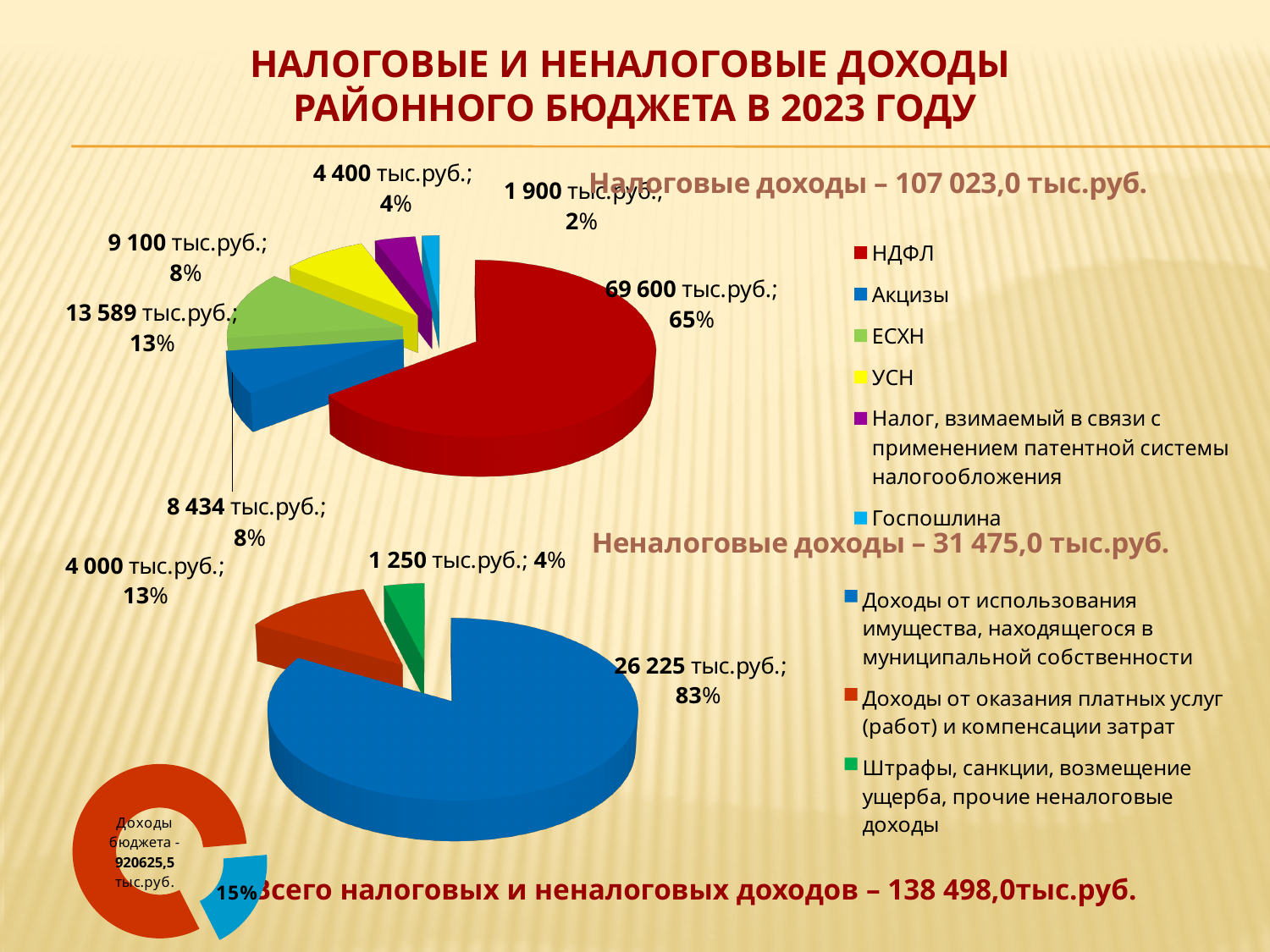
In the top chart (Налоговые доходы), which category has the largest slice? НДФЛ What kind of chart is the top chart (Налоговые доходы)? pie chart In the bottom chart (Неналоговые доходы), what is the value for Доходы от использования имущества, находящегося в муниципальной собственности? 26 225 тыс.руб. According to the heading of the top chart, what is the total of Налоговые доходы? 107 023,0 тыс.руб. In the bottom chart (Неналоговые доходы), what is the difference between the value for Доходы от использования имущества (26 225 тыс.руб.) and Доходы от оказания платных услуг (4 000 тыс.руб.)? 22 225 тыс.руб. In the top chart (Налоговые доходы), what share of the pie does Госпошлина take? 2% In the top chart (Налоговые доходы), which category has the smallest slice? Госпошлина In the bottom chart (Неналоговые доходы), what share of the pie do Штрафы, санкции, возмещение ущерба, прочие неналоговые доходы take? 4% In the top chart (Налоговые доходы), what is the value for НДФЛ? 69 600 тыс.руб. How many categories are shown in the bottom chart (Неналоговые доходы)? 3 In the top chart (Налоговые доходы), what share of the pie does НДФЛ take? 65% How many entries does the legend of the top chart (Налоговые доходы) list? 6